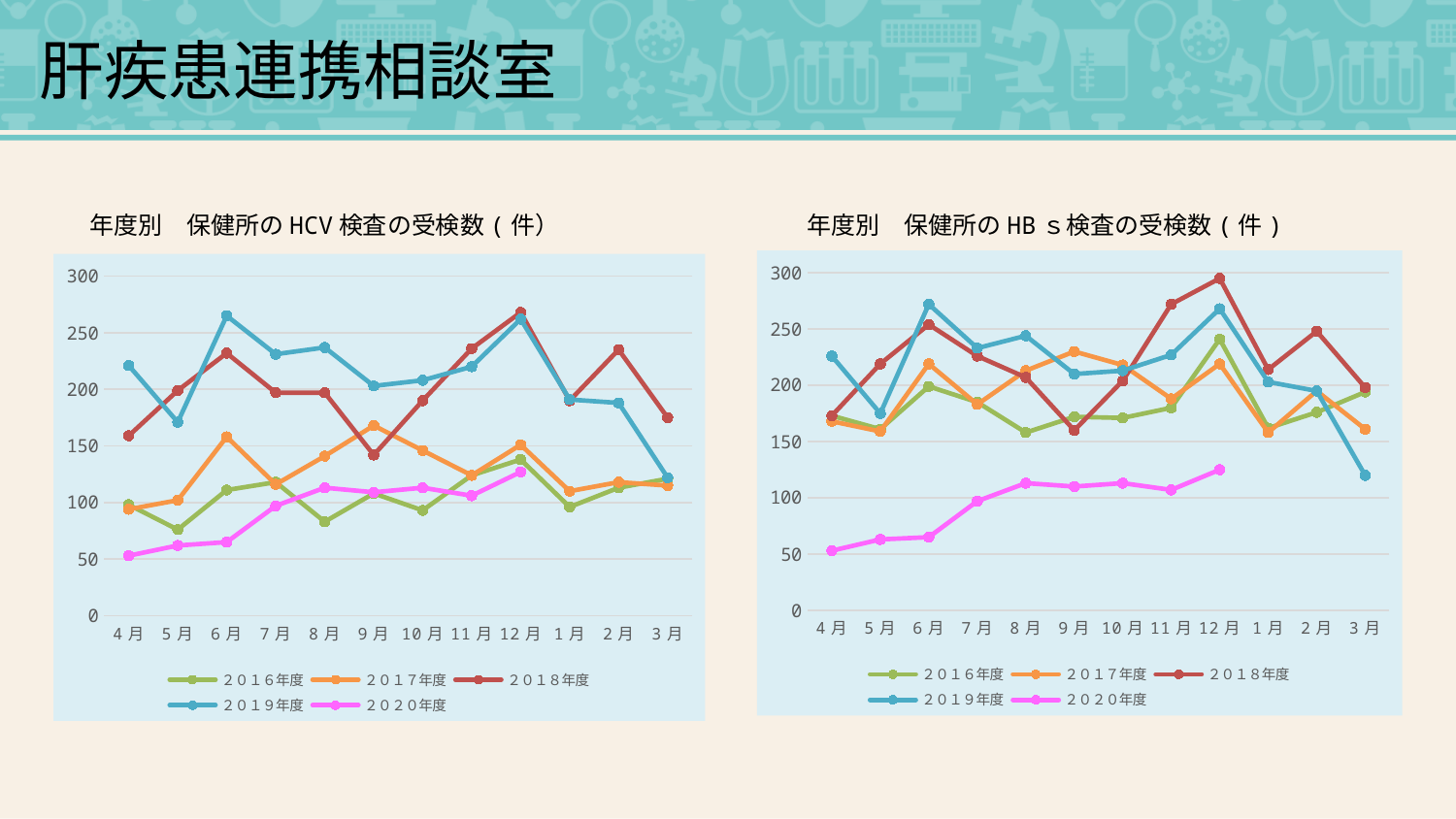
In the right chart (HB ｓ検査), is the value for 2019年度 in 3月 greater or less than 150? less In the left chart (HCV 検査), is the value for 2019年度 in 6月 greater or less than 250? greater How many months are shown on the x axis of the left chart (HCV 検査)? 12 What kind of chart is the left chart (年度別 保健所の HCV 検査の受検数)? line chart In the right chart (HB ｓ検査), is the value for 2018年度 in 12月 greater or less than 250? greater In the right chart (HB ｓ検査), does the 2020年度 line generally rise or fall from 4月 to 12月? rise In the right chart (HB ｓ検査), which series has the highest value in 12月? 2018年度 In the left chart (HCV 検査), which is larger in 4月: the value for 2019年度 or the value for 2016年度? 2019年度 How many series does the legend of the right chart (年度別 保健所の HB ｓ検査の受検数) list? 5 What is the title of the left chart? 年度別 保健所の HCV 検査の受検数（件） In the left chart (HCV 検査), which series has the lowest value in 4月? 2020年度